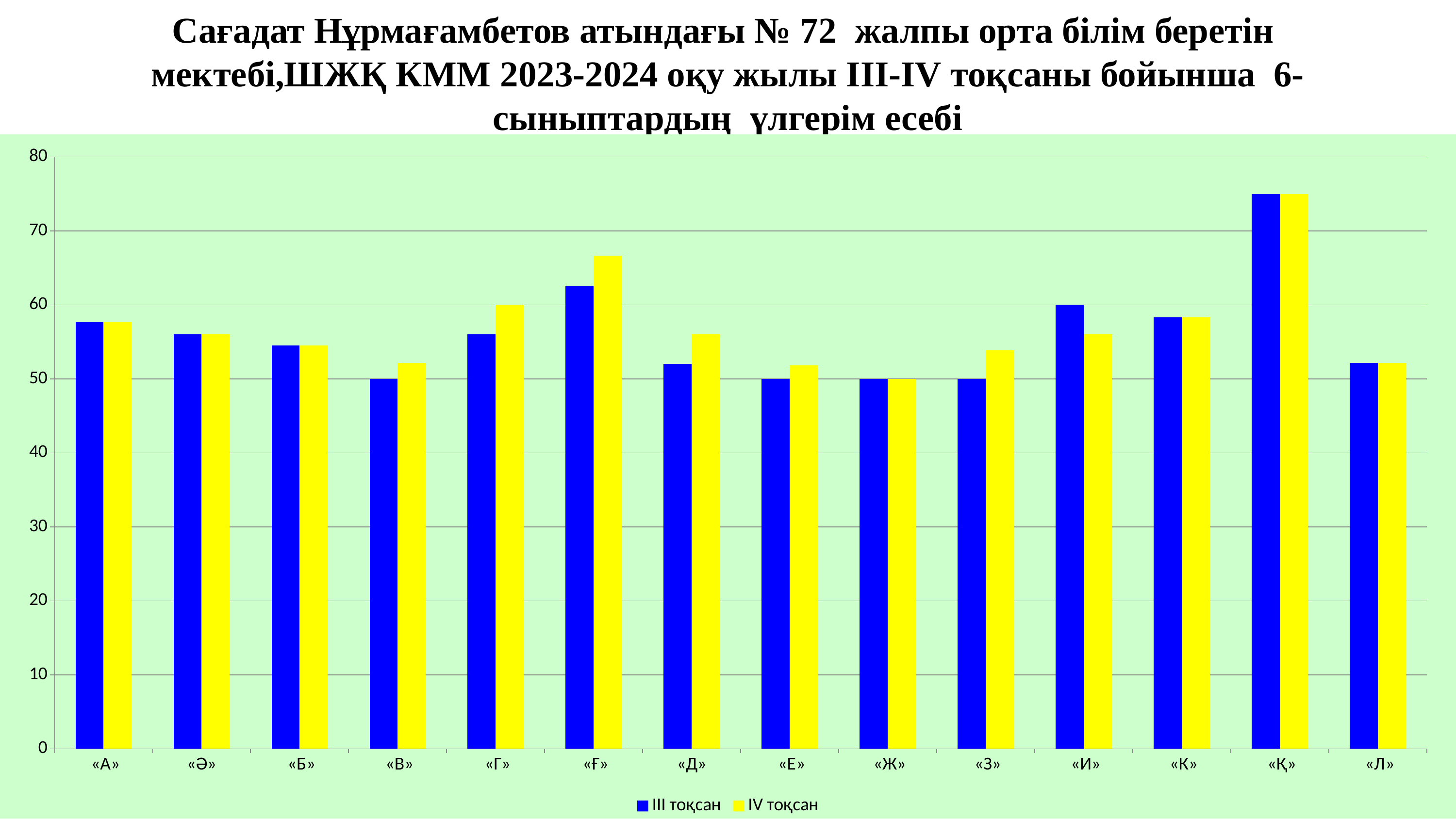
What is the difference between the III тоқсан values for «И» and «Ж»? 10 Is the IV тоқсан value for class «Ғ» greater or less than 60? greater For class «И», which series has the larger value, III тоқсан or IV тоқсан? III тоқсан Which class has the highest value for IV тоқсан? «Қ» What is the IV тоқсан value for class «Г»? 60 What are the two legend entries of the chart? III тоқсан and IV тоқсан What is the III тоқсан value for class «И»? 60 How many series does the legend list? 2 What is the III тоқсан value for class «Ж»? 50 What kind of chart is shown on the slide? bar chart How many class categories are shown on the x axis? 14 Which class has the highest value for III тоқсан? «Қ»